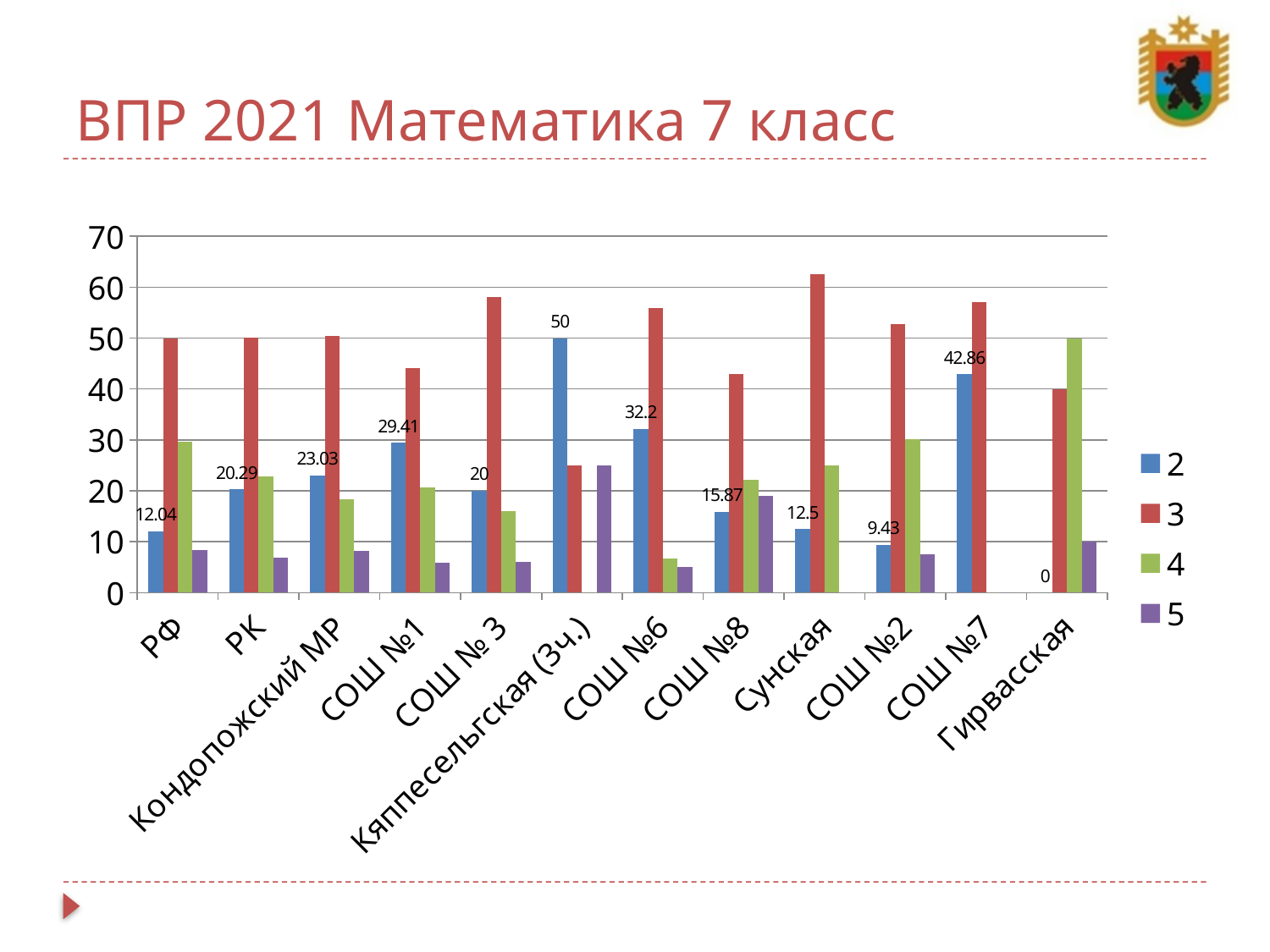
Which has the larger series 2 value, РК or Кондопожский МР? Кондопожский МР What is the difference between the series 2 values for СОШ №1 and РК? 9.12 Is the value of series 5 for Кяппесельгская (3ч.) greater or less than 20? greater How many series does the legend list? 4 What is the value of series 2 for РФ? 12.04 How many categories are shown on the x axis? 12 What is the value of series 2 for Гирвасская? 0 Which category has the highest value for series 2? Кяппесельгская (3ч.) What type of chart is shown on the slide? bar chart Which category has the lowest value for series 2? Гирвасская What is the value of series 2 for СОШ №7? 42.86 Is the value of series 3 for Сунская greater or less than 60? greater